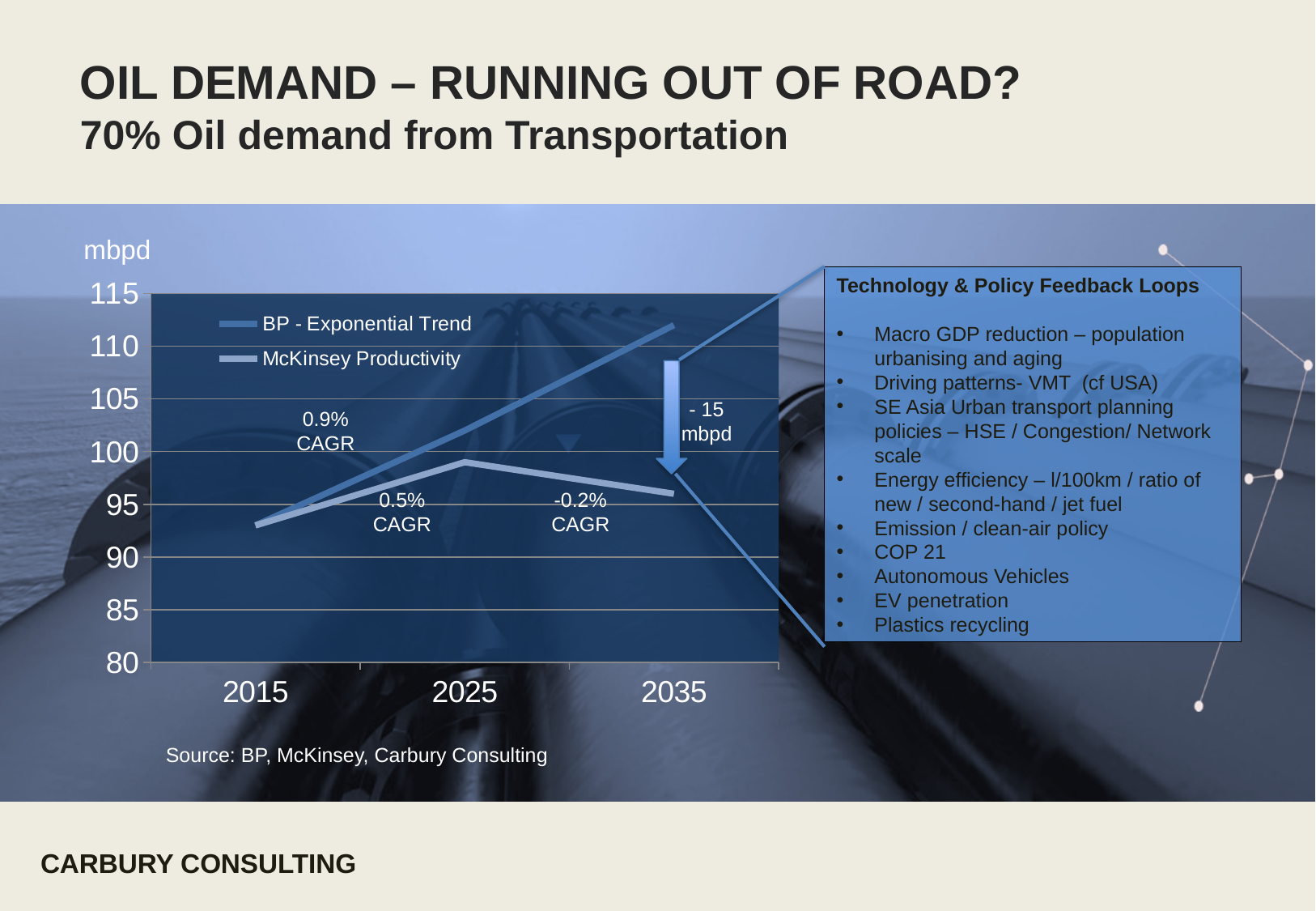
What unit is shown for the y axis of the chart? mbpd What gap between the two lines in 2035 is annotated on the chart? - 15 mbpd Is the value for BP - Exponential Trend in 2015 greater or less than 95? less Is the value for BP - Exponential Trend in 2035 greater or less than 110? greater Is the value for McKinsey Productivity in 2035 greater or less than 100? less Does the BP - Exponential Trend line rise or fall from 2015 to 2035? rise Which series is higher in 2035, BP - Exponential Trend or McKinsey Productivity? BP - Exponential Trend Does the McKinsey Productivity line rise or fall from 2025 to 2035? fall How many series does the chart legend list? 2 How many years are labelled on the x axis of the chart? 3 What kind of chart is shown on the slide? line chart What CAGR is annotated for the McKinsey Productivity line between 2025 and 2035? -0.2% CAGR